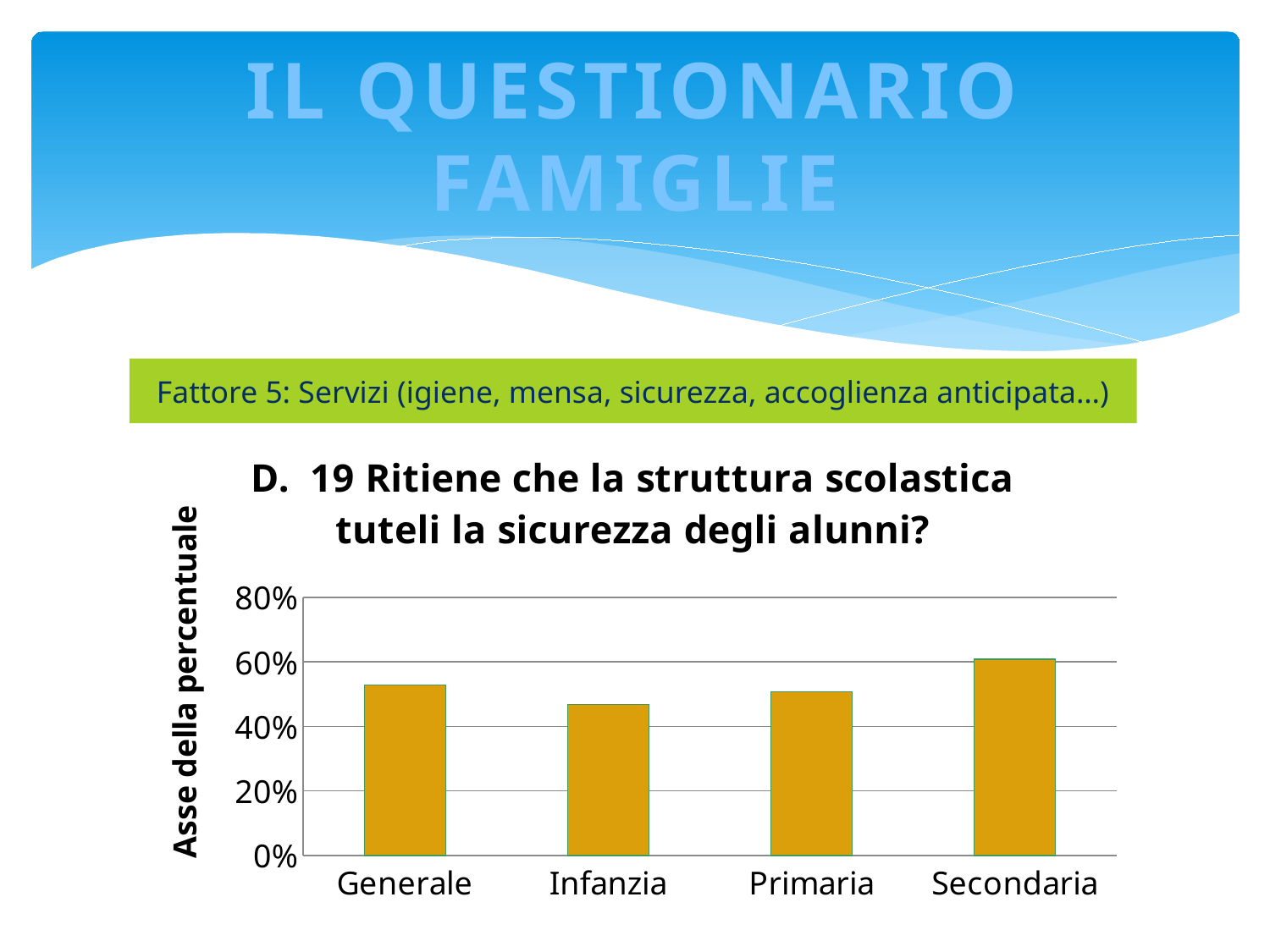
What is the label of the vertical axis of the chart? Asse della percentuale What is the title of the chart? D. 19 Ritiene che la struttura scolastica tuteli la sicurezza degli alunni? Is the value for Generale greater or less than 40%? greater Which is larger, the value for Secondaria or the value for Primaria? Secondaria Is the value for Secondaria greater or less than 40%? greater Which category has the lowest value in the chart? Infanzia Which is larger, the value for Generale or the value for Infanzia? Generale Which category has the highest value in the chart? Secondaria Is the value for Infanzia greater or less than 60%? less What kind of chart is shown on the slide? bar chart How many categories are shown on the x axis of the chart? 4